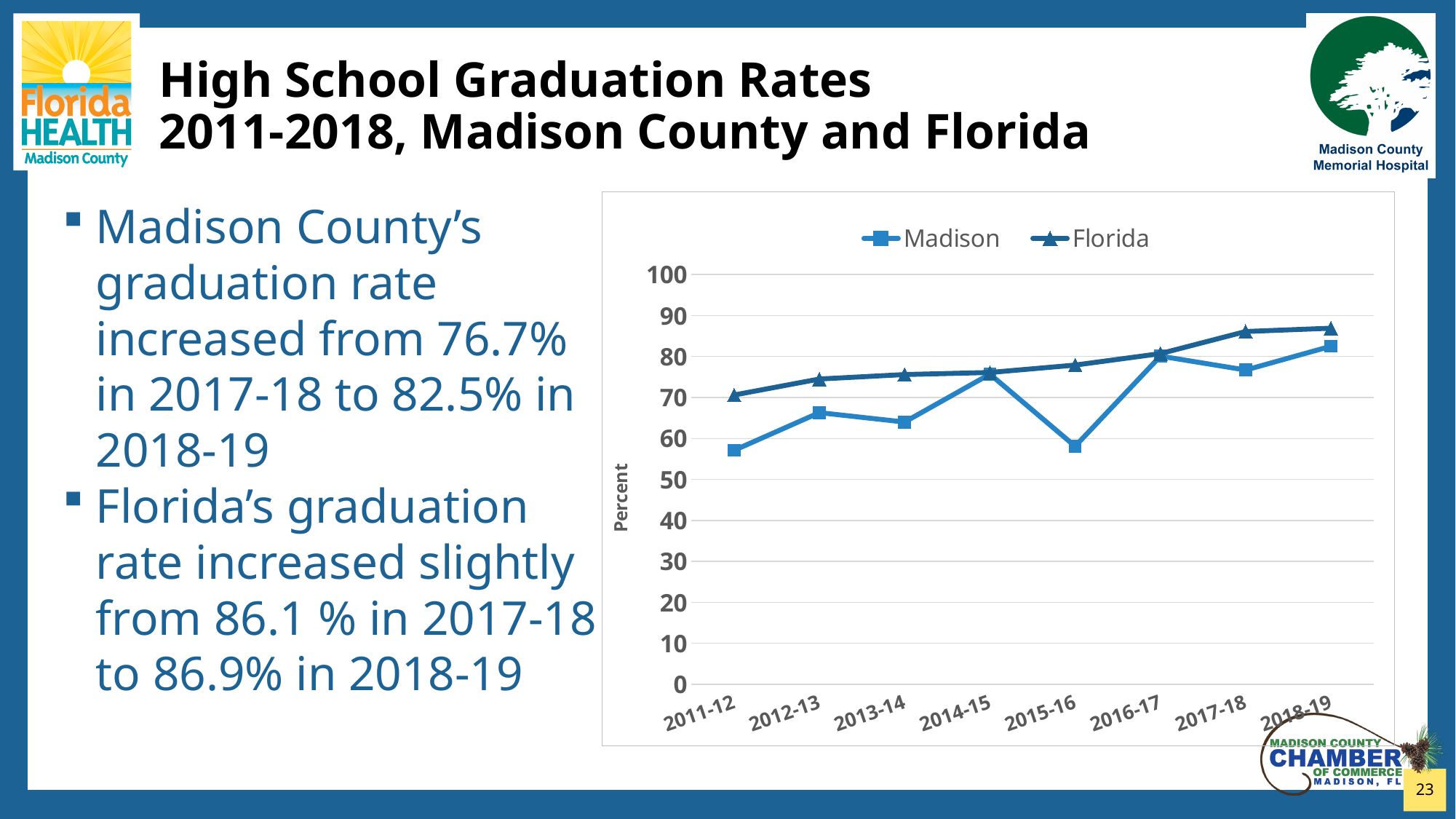
What is the difference between Florida's and Madison County's graduation rates in 2018-19? 4.4 How many school years are plotted along the x axis? 8 What was Florida's graduation rate in 2017-18? 86.1% What kind of chart is shown on the slide? line chart Is the Madison value for 2011-12 greater or less than 60? less What is the label on the vertical axis of the chart? Percent In which school year does the Madison series reach its highest value? 2018-19 In 2015-16, which series has the higher value, Madison or Florida? Florida How many series does the chart legend list? 2 What was Madison County's graduation rate in 2018-19? 82.5% By how many percentage points did Madison County's graduation rate increase from 2017-18 to 2018-19? 5.8 Is the Florida value for 2013-14 greater or less than 70? greater